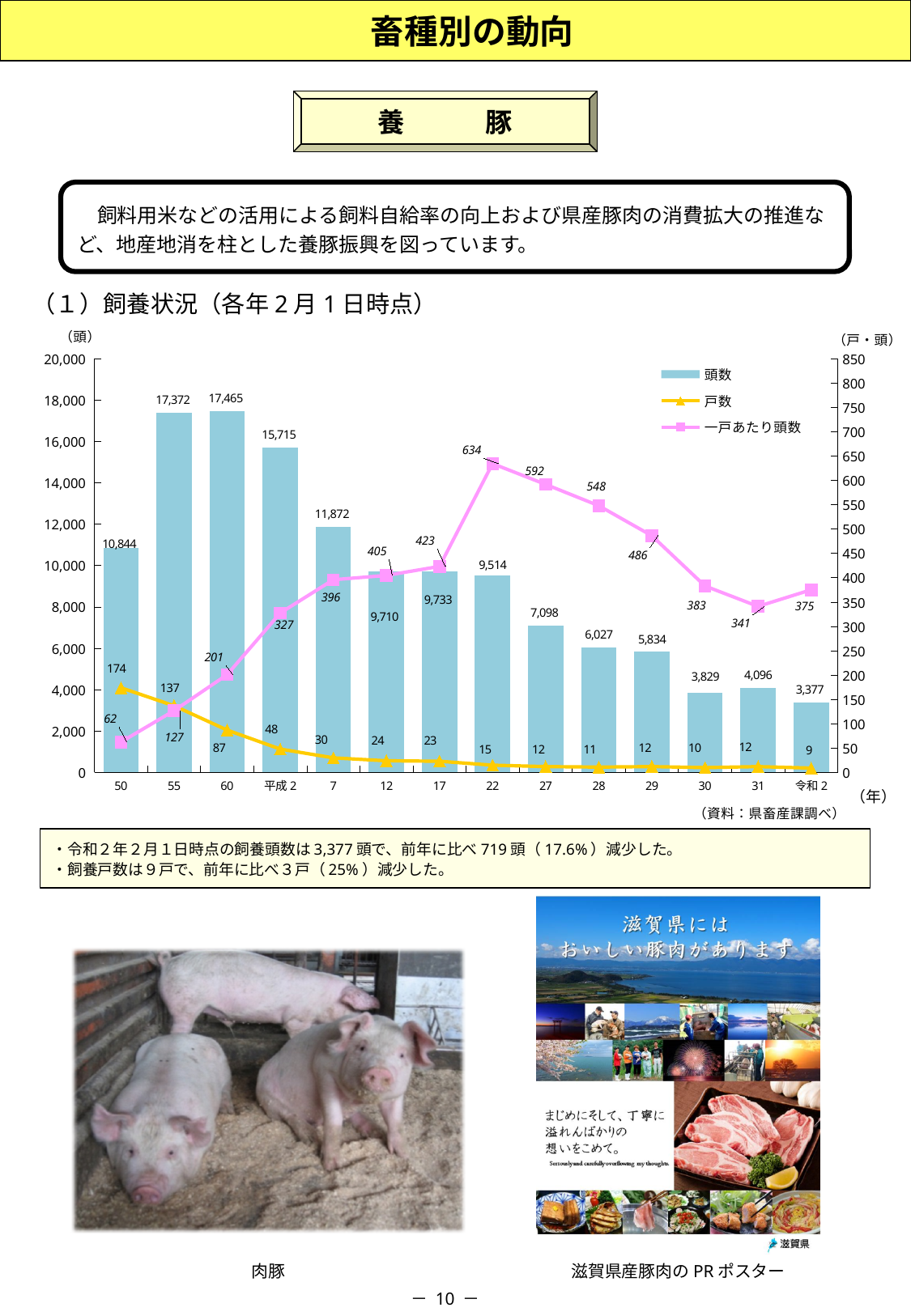
What is the 戸数 value for 50? 174 Which year has the lowest 戸数? 令和2 Which year has the highest 頭数? 60 How many series does the legend list? 3 How many years are shown on the x axis? 14 Which is larger, the 一戸あたり頭数 for 27 or for 28? 27 What is the 頭数 value for 令和2? 3,377 Is the 頭数 value for 7 greater or less than 10,000? greater Does the 戸数 series rise or fall from 50 to 令和2? fall Which series is drawn as bars? 頭数 What is the 一戸あたり頭数 value for 22? 634 What is the difference in 頭数 between 31 and 令和2? 719